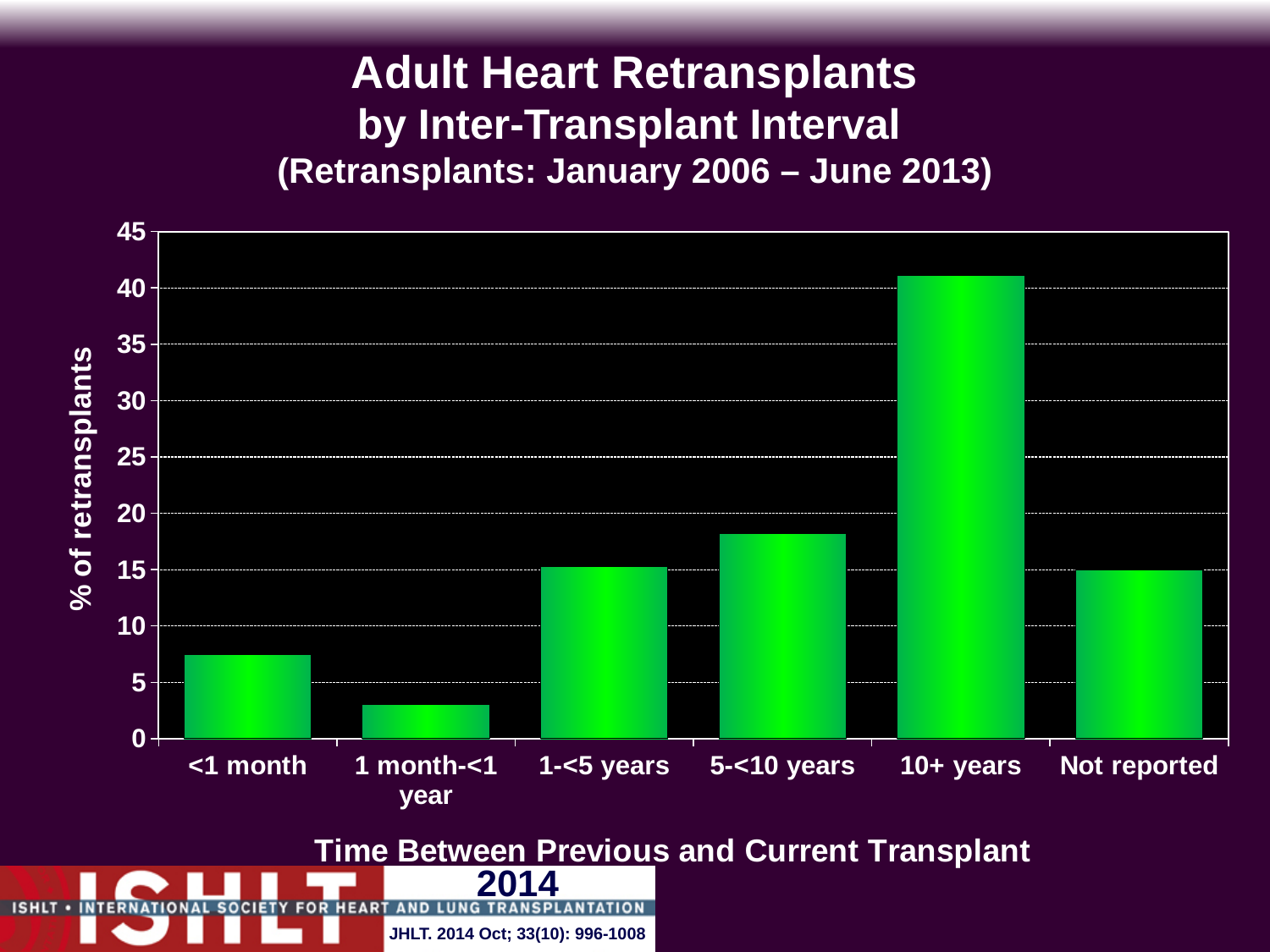
Is the value for 1-<5 years greater or less than 20? less Is the value for 10+ years greater or less than 40? greater How many categories are shown on the x axis? 6 Is the value for 1 month-<1 year greater or less than 5? less What is the label of the x axis? Time Between Previous and Current Transplant What is the label of the y axis? % of retransplants Which inter-transplant interval has the lowest percentage of retransplants? 1 month-<1 year What kind of chart is shown on the slide? bar chart Which is larger, the value for 5-<10 years or the value for <1 month? 5-<10 years Which inter-transplant interval has the highest percentage of retransplants? 10+ years